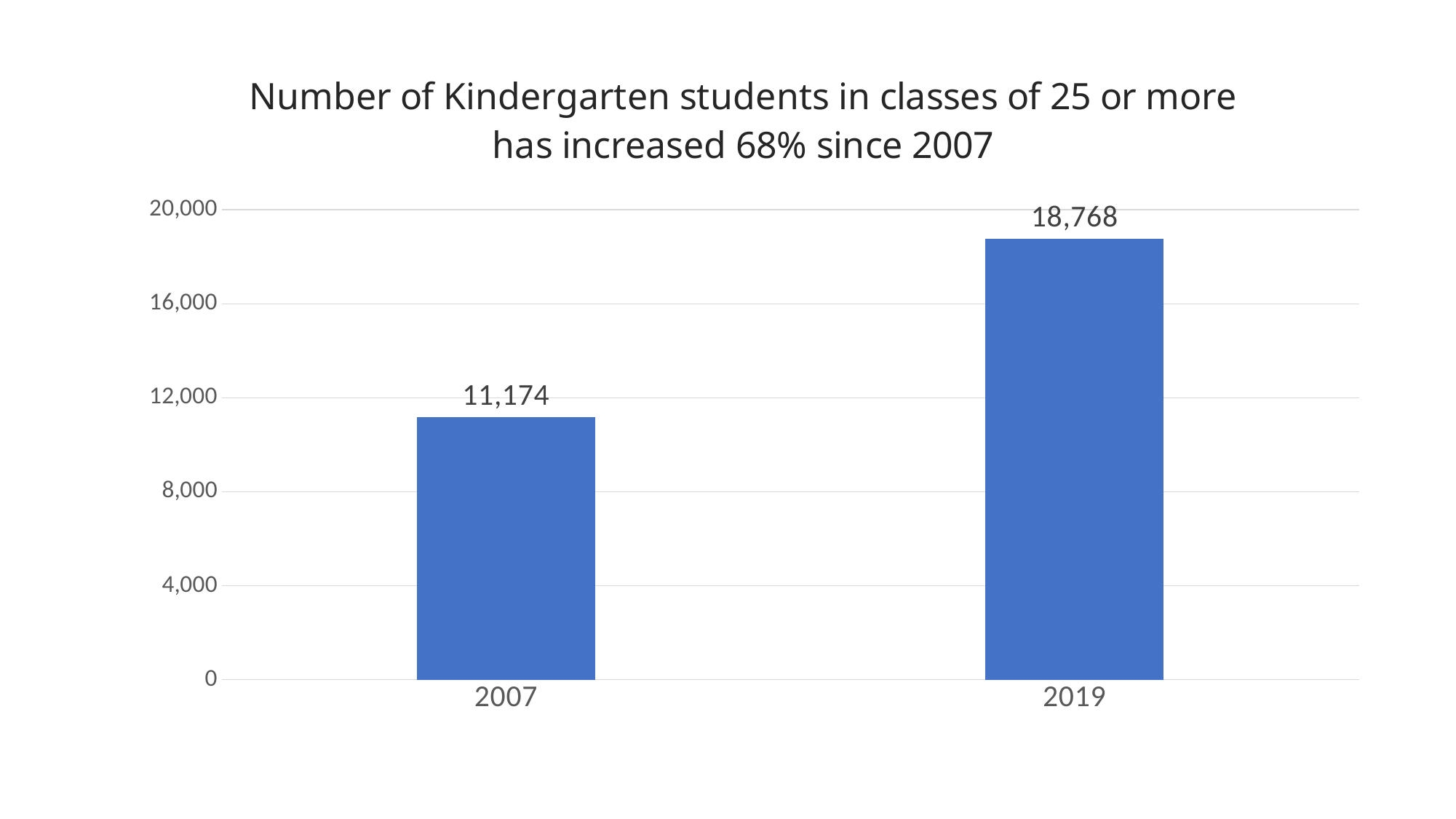
How many bars are shown in the chart? 2 What is the value for 2019? 18,768 What is the value for 2007? 11,174 Which year has the higher value? 2019 Is the value for 2019 greater or less than 16,000? greater According to the chart title, by what percentage has the number of Kindergarten students in classes of 25 or more increased since 2007? 68% What kind of chart is shown on the slide? Bar chart Which year has the lower value? 2007 Is the value for 2007 greater or less than 12,000? less Do the values rise or fall from 2007 to 2019? Rise Is the value for 2019 larger than the value for 2007? Yes What is the difference between the 2019 value and the 2007 value? 7,594